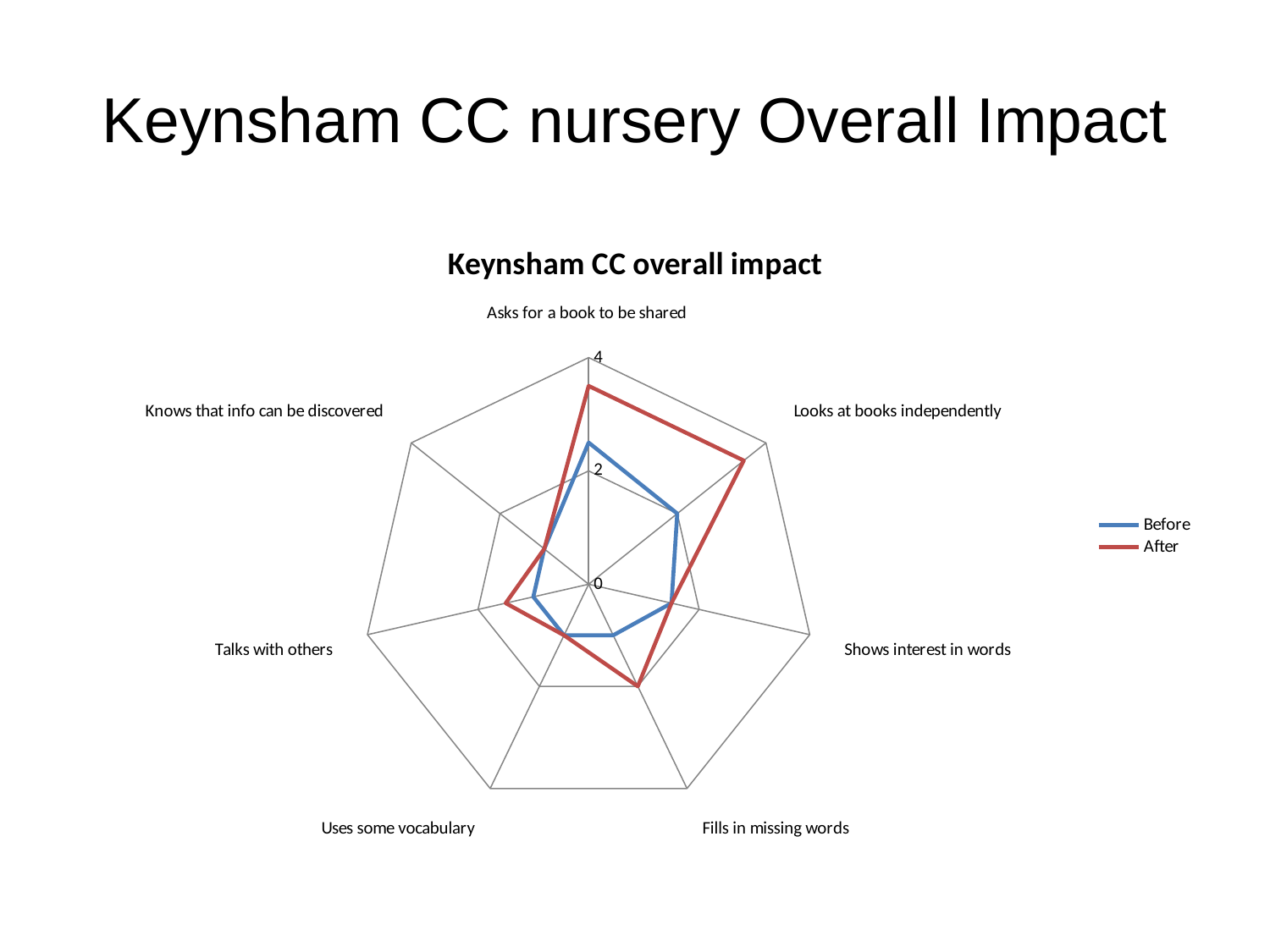
For 'Asks for a book to be shared', which series has the larger value, Before or After? After Which category has the highest value for the Before series? Asks for a book to be shared How many series does the legend list? 2 Is the After value for 'Looks at books independently' greater or less than 2? greater Is the Before value for 'Fills in missing words' greater or less than 2? less How many categories (axes) does the radar chart have? 7 What are the two series named in the legend? Before and After What kind of chart is shown on the slide? Radar chart For 'Looks at books independently', which series has the larger value, Before or After? After Is the After value for 'Asks for a book to be shared' greater or less than 2? greater What is the title of the chart? Keynsham CC overall impact